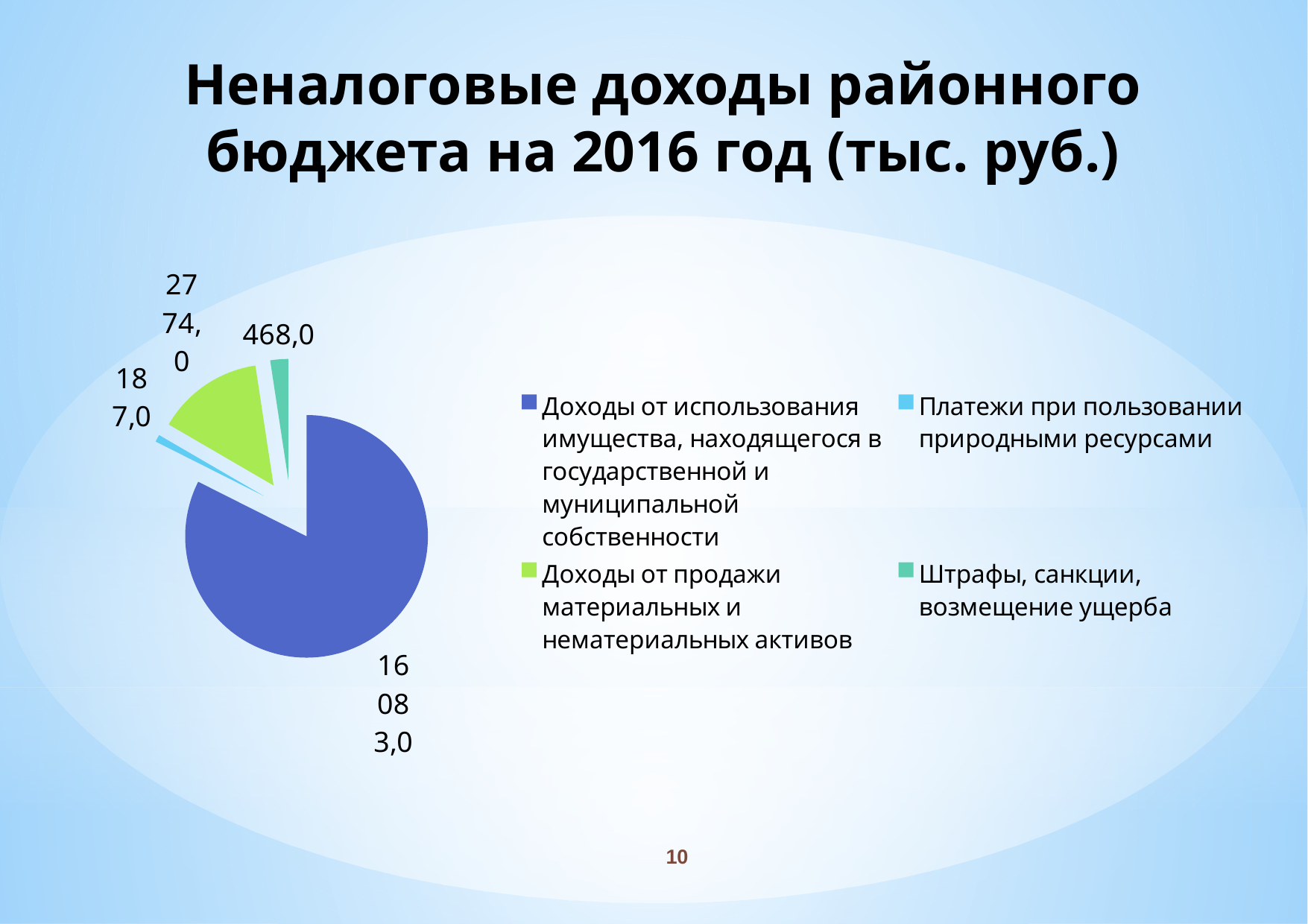
What is the value for «Доходы от продажи материальных и нематериальных активов»? 2774,0 What is the value for «Доходы от использования имущества, находящегося в государственной и муниципальной собственности»? 16083,0 What is the value for «Платежи при пользовании природными ресурсами»? 187,0 What is the value for «Штрафы, санкции, возмещение ущерба»? 468,0 What is the difference between «Доходы от продажи материальных и нематериальных активов» and «Штрафы, санкции, возмещение ущерба»? 2306,0 How many categories does the pie chart have? 4 What is the total of all four values in the pie chart? 19512,0 Which is larger: «Штрафы, санкции, возмещение ущерба» or «Платежи при пользовании природными ресурсами»? Штрафы, санкции, возмещение ущерба Which category has the largest slice of the pie? Доходы от использования имущества, находящегося в государственной и муниципальной собственности What is the title of the slide? Неналоговые доходы районного бюджета на 2016 год (тыс. руб.) Which category has the smallest slice of the pie? Платежи при пользовании природными ресурсами What type of chart is shown on the slide? Pie chart